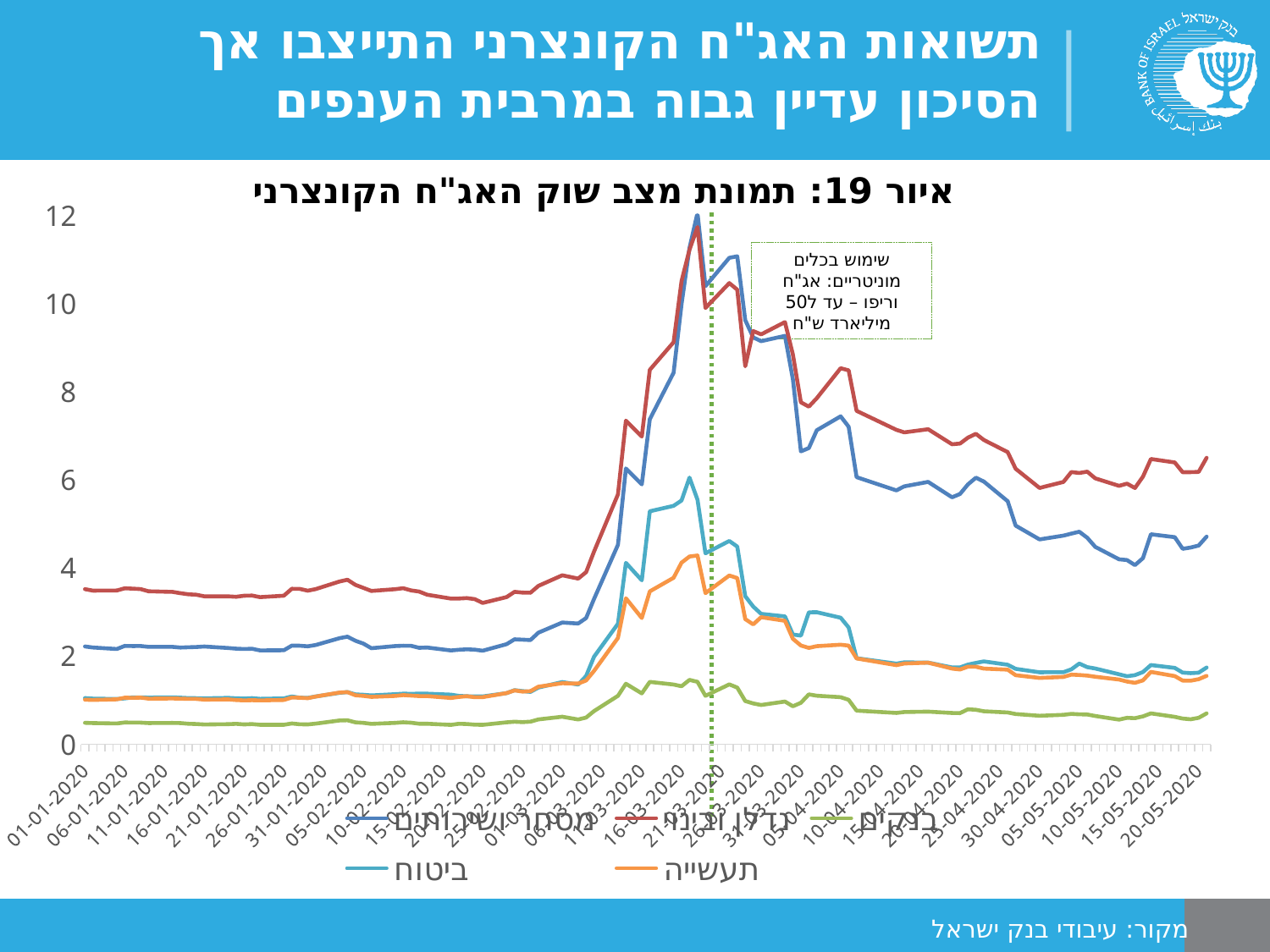
Is the value for נדל"ן ובינוי on 01-01-2020 greater or less than 2? greater Is the value for מסחר ושירותים on 20-05-2020 greater or less than 4? greater What kind of chart is shown on the slide? line chart How many series does the legend list? 5 Is the peak value of מסחר ושירותים in March 2020 greater or less than 10? greater What is the title of the chart? איור 19: תמונת מצב שוק האג"ח הקונצרני What colour is the line for בנקים? green Which series has the highest value at the end of the period (20-05-2020)? נדל"ן ובינוי On 20-05-2020, which is larger: מסחר ושירותים or ביטוח? מסחר ושירותים Which series has the lowest values throughout the chart? בנקים From its peak in late March 2020 to 20-05-2020, does the נדל"ן ובינוי series rise or fall? fall